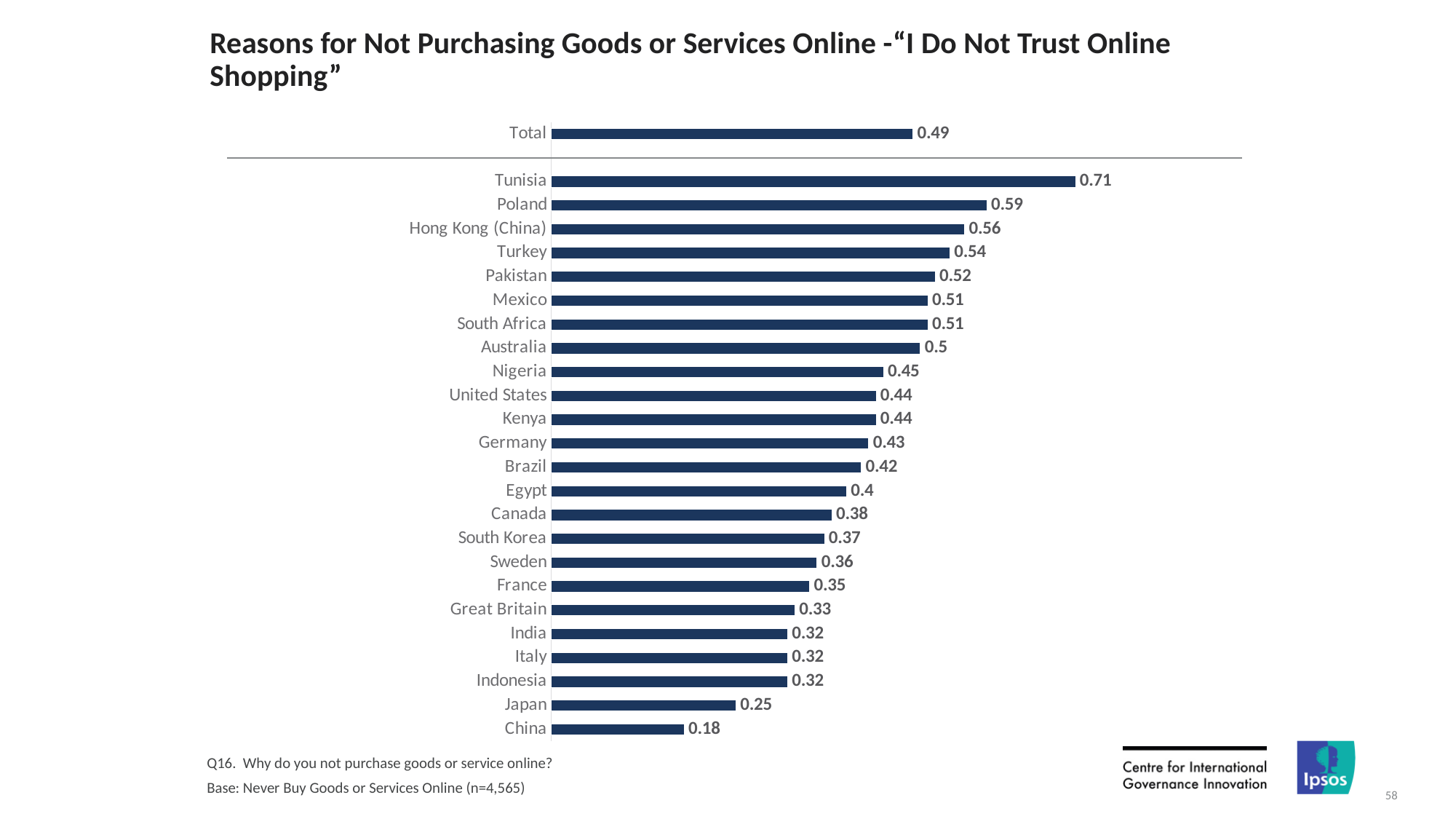
What is the value for the Total bar? 0.49 Which country has the lowest value? China What is the value for Japan? 0.25 What is the value for Tunisia? 0.71 Which has a larger value, Canada or Germany? Germany What is the value for Hong Kong (China)? 0.56 Which country has the highest value? Tunisia How many country bars are shown below the Total bar? 24 What kind of chart is shown on the slide? Bar chart What is the difference between the values for Tunisia and China? 0.53 What is the difference between the values for Poland and Turkey? 0.05 What is the title of the chart? Reasons for Not Purchasing Goods or Services Online - "I Do Not Trust Online Shopping"